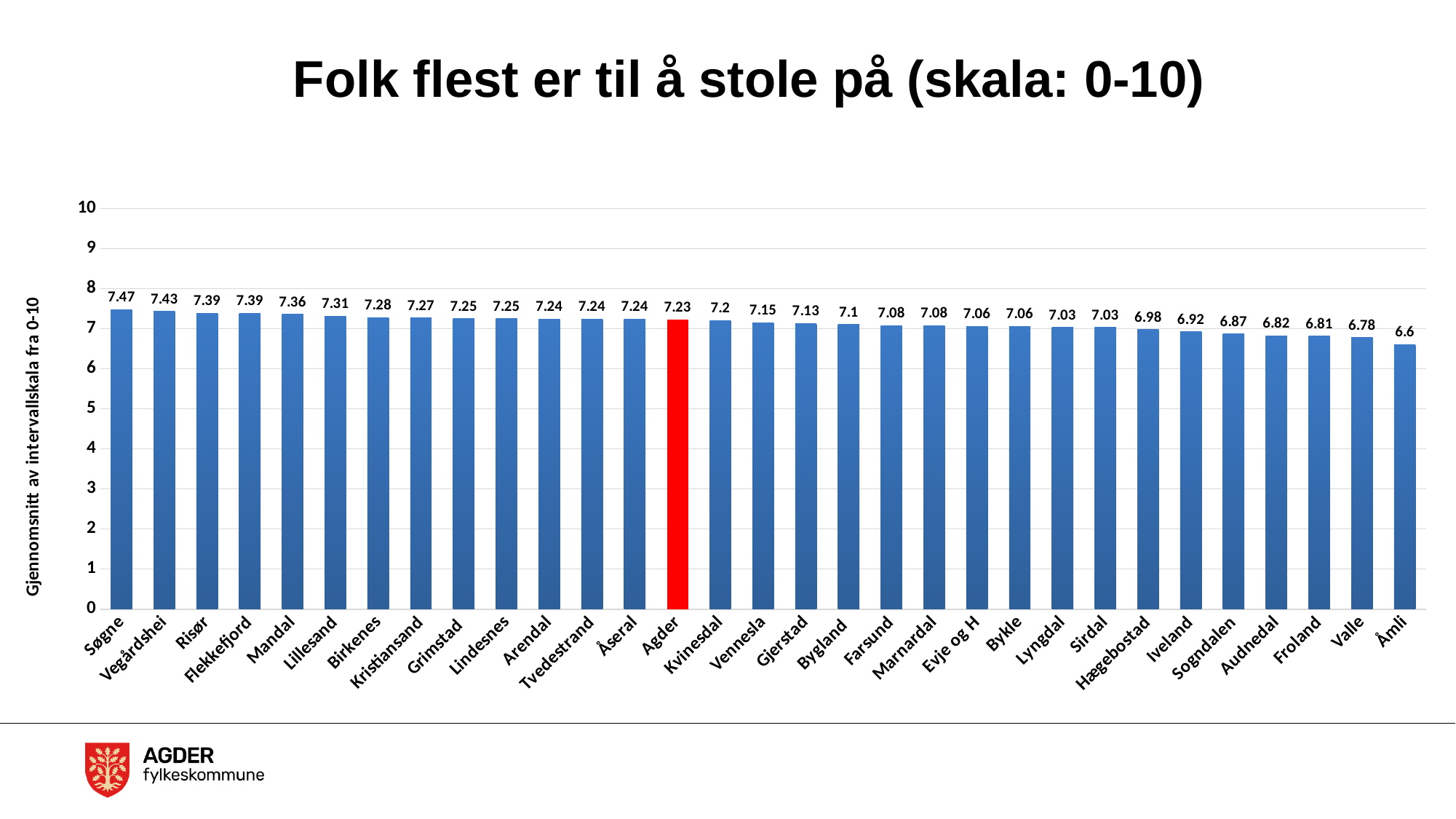
Do the values rise or fall from left to right along the x axis? Fall Which category has the highest value? Søgne What is the value for Kristiansand? 7.27 What is the value for Agder? 7.23 What kind of chart is this? Bar chart Which bar is coloured red instead of blue? Agder What is the value for Åmli? 6.6 How many categories are shown on the x axis? 31 Which is larger, the value for Mandal or the value for Vennesla? Mandal What is the difference between the values for Søgne and Åmli? 0.87 What is the value for Søgne? 7.47 Which category has the lowest value? Åmli